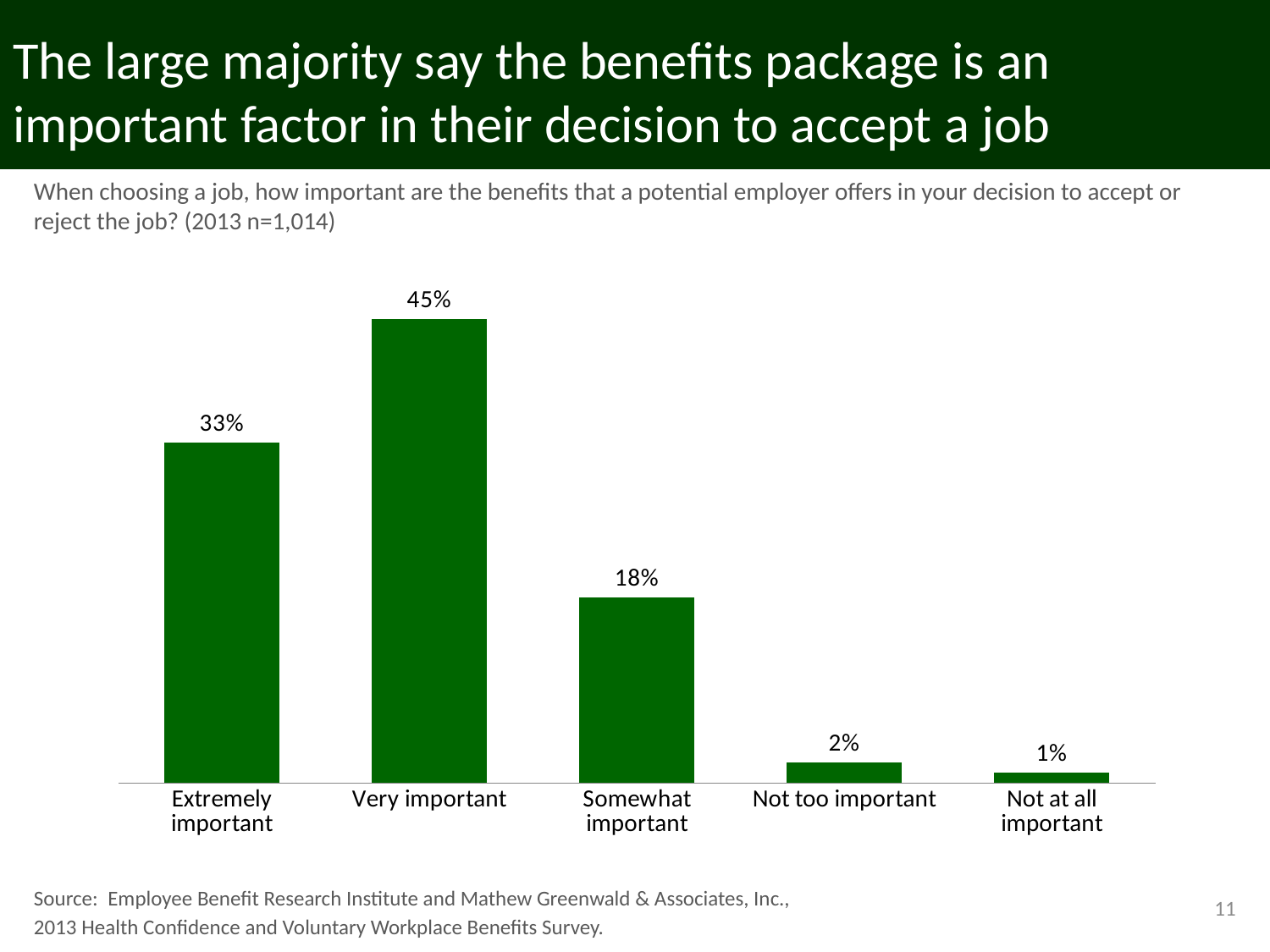
What is the difference in percentage points between "Very important" and "Extremely important"? 12 Which is larger, the percentage for "Extremely important" or for "Somewhat important"? Extremely important Which response category has the highest percentage? Very important What percentage of respondents said benefits are "Very important" in their decision to accept or reject a job? 45% What percentage of respondents said benefits are "Somewhat important"? 18% What percentage of respondents said benefits are "Extremely important"? 33% What is the sample size (n) given for the 2013 survey question? 1,014 What type of chart is shown on the slide? Bar chart What percentage of respondents said benefits are "Not too important"? 2% How many response categories are shown in the chart? 5 What percentage of respondents said benefits are "Not at all important"? 1% Which response category has the lowest percentage? Not at all important